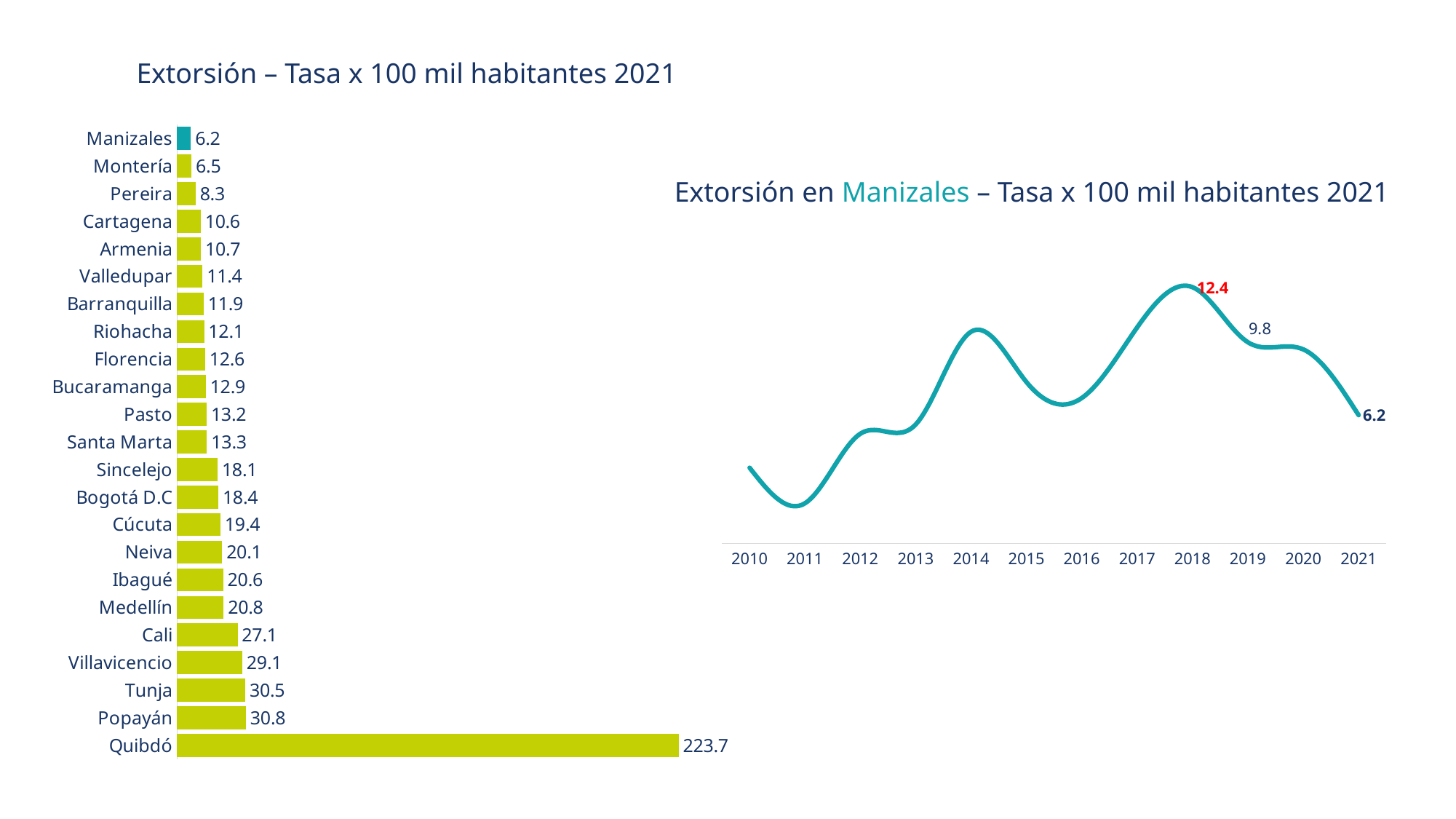
In the bar chart 'Extorsión – Tasa x 100 mil habitantes 2021', what is the value for Bogotá D.C? 18.4 What kind of chart is the chart on the left of the slide? Bar chart In the bar chart 'Extorsión – Tasa x 100 mil habitantes 2021', which is larger, the value for Medellín or the value for Cúcuta? Medellín In the bar chart 'Extorsión – Tasa x 100 mil habitantes 2021', which city has the highest value? Quibdó In the bar chart 'Extorsión – Tasa x 100 mil habitantes 2021', what is the difference between the values for Quibdó and Popayán? 192.9 In the line chart 'Extorsión en Manizales – Tasa x 100 mil habitantes 2021', what is the value for 2018? 12.4 In the bar chart 'Extorsión – Tasa x 100 mil habitantes 2021', what is the value for Cali? 27.1 In the bar chart 'Extorsión – Tasa x 100 mil habitantes 2021', which city has the lowest value? Manizales How many cities are shown in the bar chart 'Extorsión – Tasa x 100 mil habitantes 2021'? 23 In the line chart 'Extorsión en Manizales – Tasa x 100 mil habitantes 2021', do the values rise or fall from 2018 to 2021? Fall In the line chart 'Extorsión en Manizales – Tasa x 100 mil habitantes 2021', what is the value for 2019? 9.8 In the line chart 'Extorsión en Manizales – Tasa x 100 mil habitantes 2021', what is the difference between the values for 2018 and 2021? 6.2